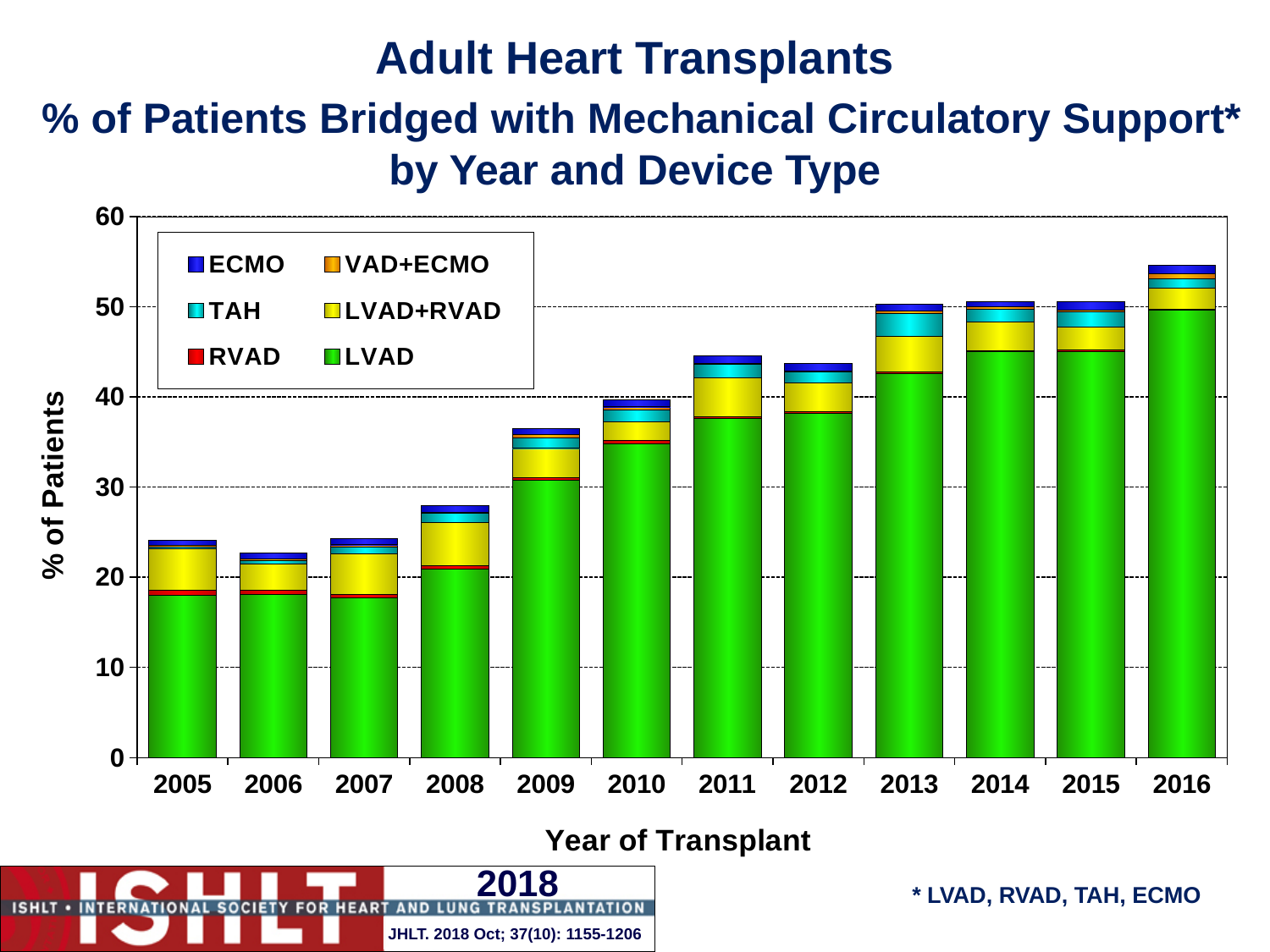
Which year has the highest total % of patients bridged with mechanical circulatory support? 2016 How many years are shown along the x axis of the chart? 12 How many device types does the legend list? 6 Is the total value for 2008 greater or less than 30? less Is the total value for 2016 greater or less than 50? greater Overall, do the total values rise or fall from 2005 to 2016? rise What is the label on the y axis of the chart? % of Patients What kind of chart is shown on the slide? Stacked bar chart Which year has a larger total, 2009 or 2010? 2010 Is the total value for 2012 greater or less than 50? less Which year has the lowest total % of patients bridged with mechanical circulatory support? 2006